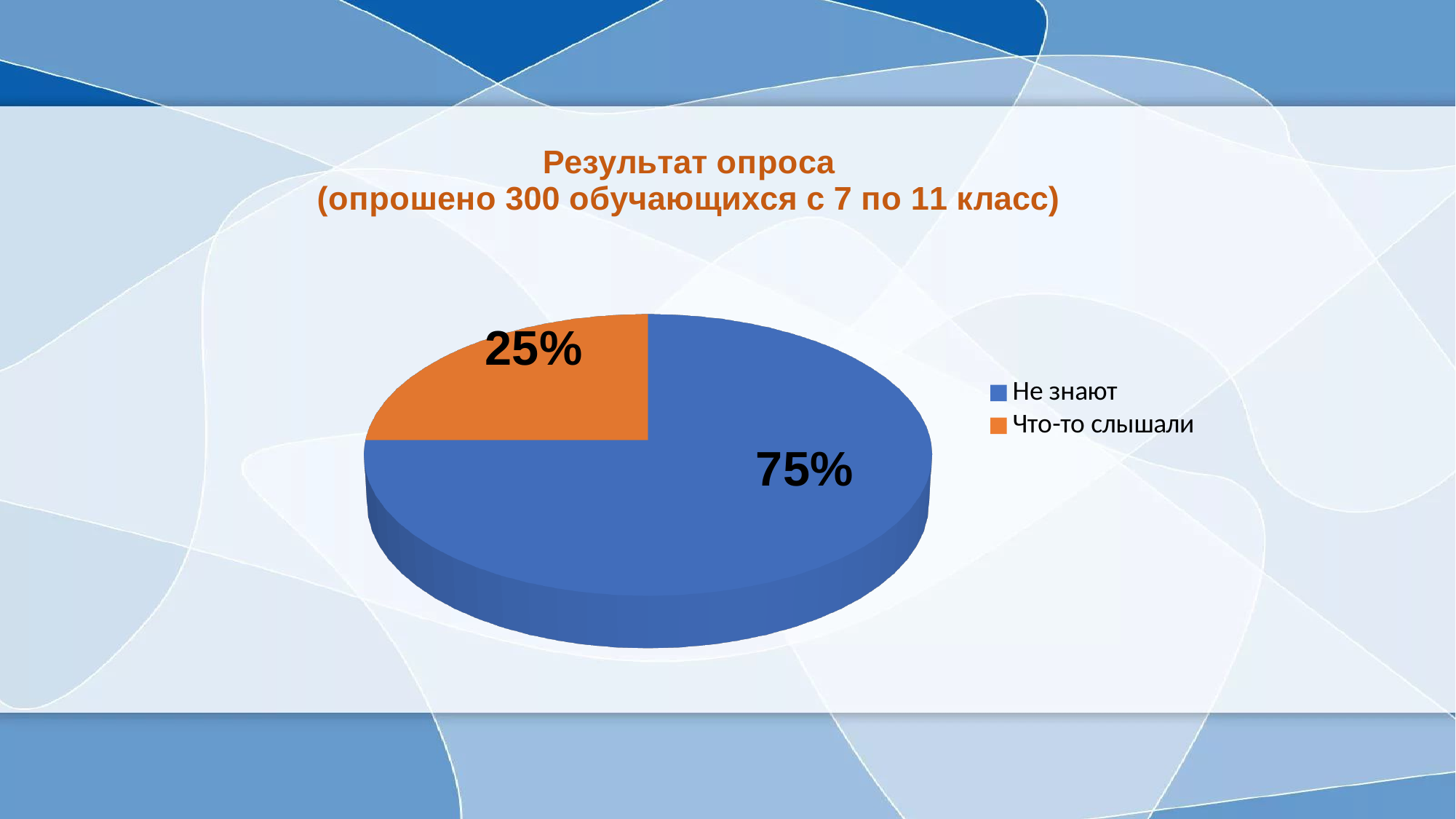
Which category has the smallest slice of the pie? Что-то слышали Which is larger: the slice for "Не знают" or the slice for "Что-то слышали"? Не знают How many slices does the pie chart have? 2 What colour is the slice for "Что-то слышали"? Orange What is the difference in percentage points between "Не знают" and "Что-то слышали"? 50 How many entries does the legend list? 2 What share of the pie does "Что-то слышали" take? 25% How many students were surveyed according to the chart title? 300 Which category has the largest slice of the pie? Не знают What kind of chart is shown on the slide? Pie chart What share of the pie does "Не знают" take? 75%